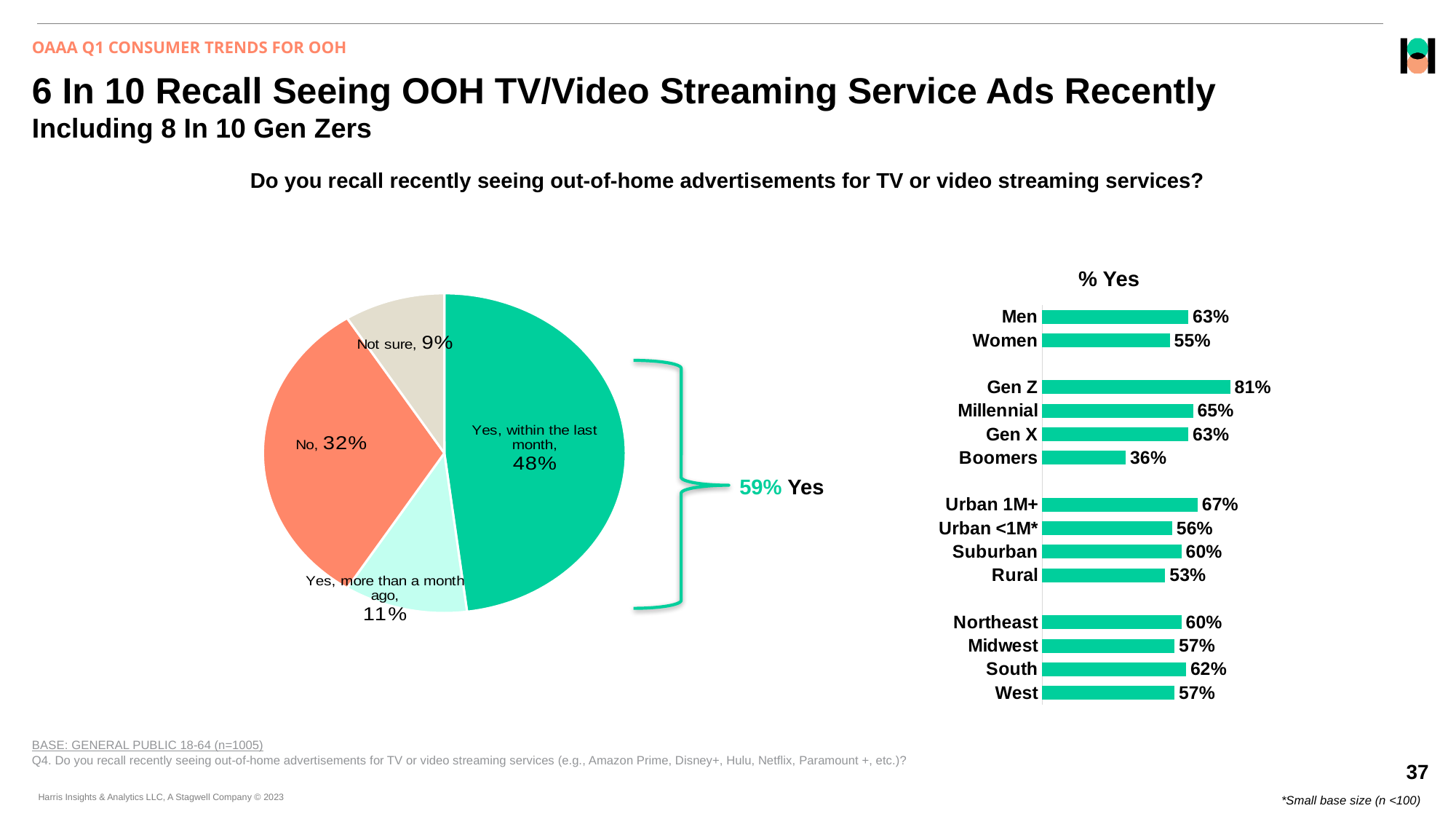
In the '% Yes' bar chart on the right, what is the value for Gen Z? 81% In the '% Yes' bar chart on the right, which category has the lowest value? Boomers In the pie chart on the left, what is the combined share of the two 'Yes' responses? 59% In the '% Yes' bar chart on the right, which category has the highest value? Gen Z In the '% Yes' bar chart on the right, what is the difference between Men and Women? 8% In the '% Yes' bar chart on the right, which is larger, Urban 1M+ or Suburban? Urban 1M+ In the pie chart on the left, what share of respondents answered 'No'? 32% In the pie chart on the left, what share of respondents answered 'Yes, within the last month'? 48% In the '% Yes' bar chart on the right, what is the value for Rural? 53% In the pie chart on the left, which response has the smallest slice? Not sure In the pie chart on the left, how many slices are there? 4 What type of chart is shown on the right side of the slide? Bar chart